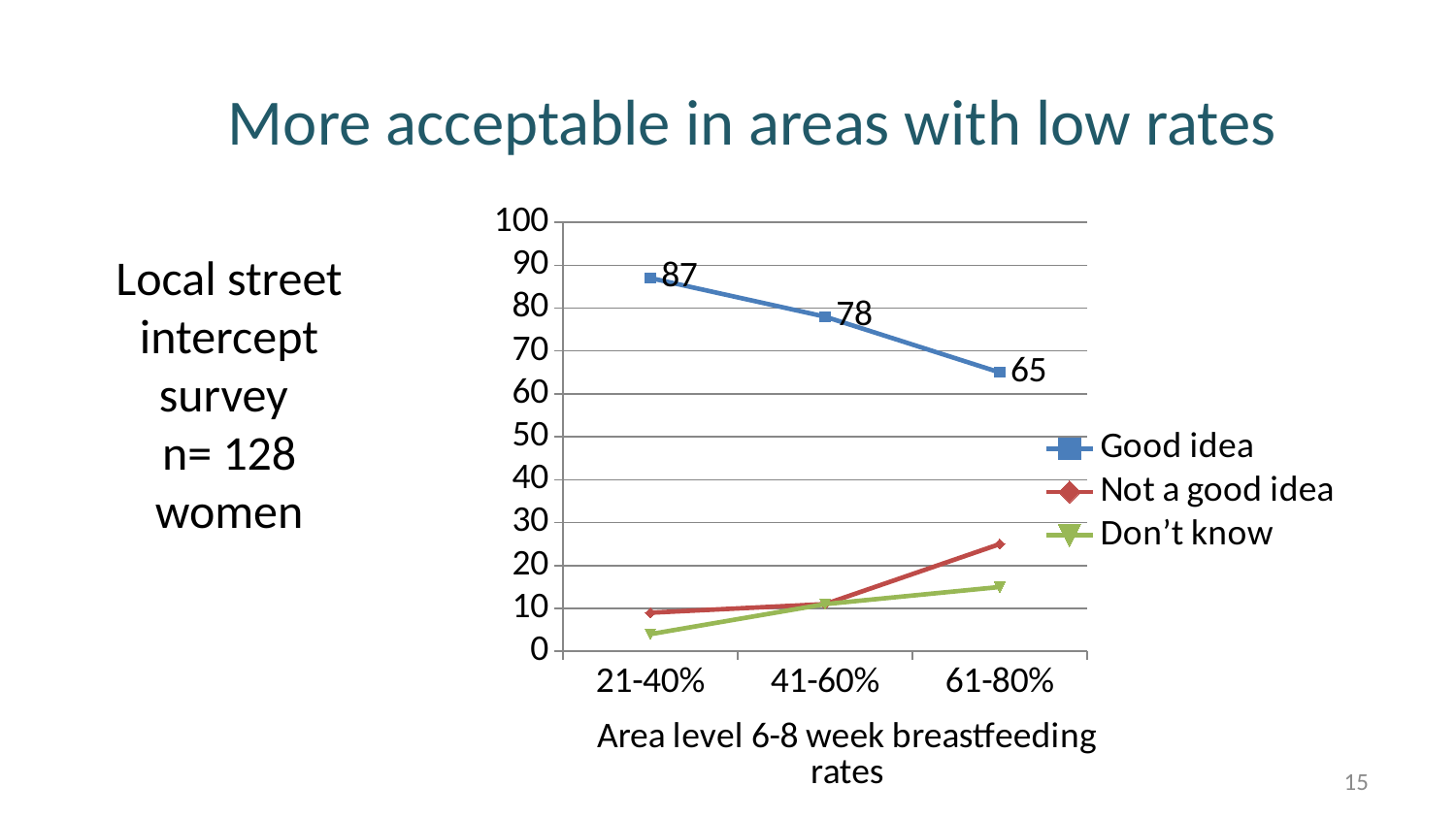
Does the Not a good idea line rise or fall from 21-40% to 61-80%? rise At which area level is the Good idea value highest? 21-40% At which area level is the Good idea value lowest? 61-80% What is the value for Good idea at 21-40%? 87 Is the value for Not a good idea at 61-80% greater or less than 20? greater What is the difference between the Good idea values at 21-40% and 61-80%? 22 Is the value for Don't know at 21-40% greater or less than 10? less What is the value for Good idea at 41-60%? 78 What kind of chart is shown on the slide? line chart How many series does the legend list? 3 What is the value for Good idea at 61-80%? 65 Does the Good idea line rise or fall as the area level breastfeeding rate increases? fall